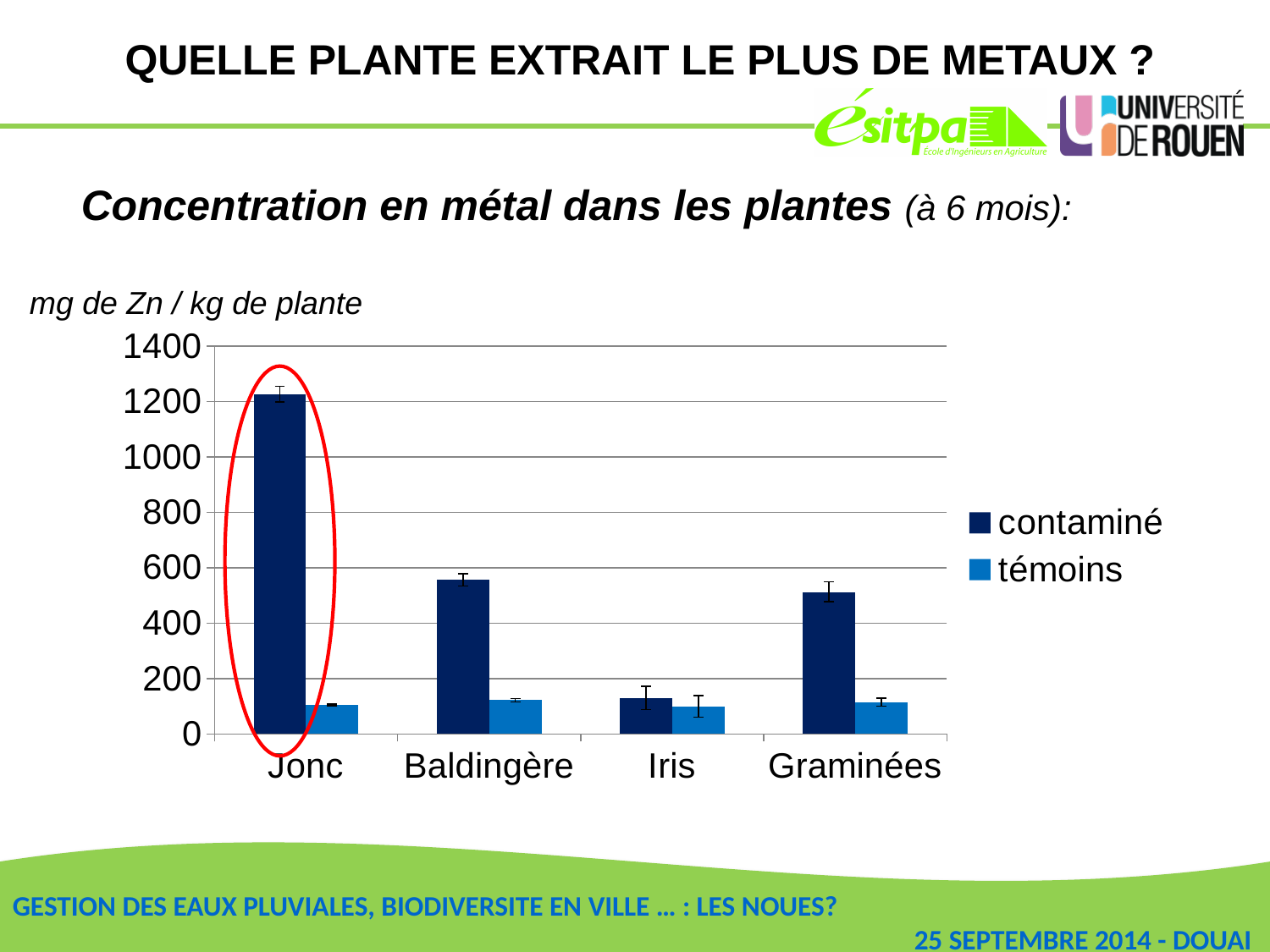
Which plant's bars are circled in red on the chart? Jonc What kind of chart is shown on the slide? bar chart How many plant categories are shown on the x axis? 4 How many series does the legend list? 2 Is the 'contaminé' value for Iris greater or less than 200? less Which is larger: the 'contaminé' value for Jonc or the 'contaminé' value for Baldingère? Jonc Which plant has the highest 'contaminé' value? Jonc Is the 'contaminé' value for Jonc greater or less than 1000? greater Which plant has the lowest 'contaminé' value? Iris Is the 'contaminé' value for Baldingère greater or less than 400? greater What unit is given for the y axis of the chart? mg de Zn / kg de plante